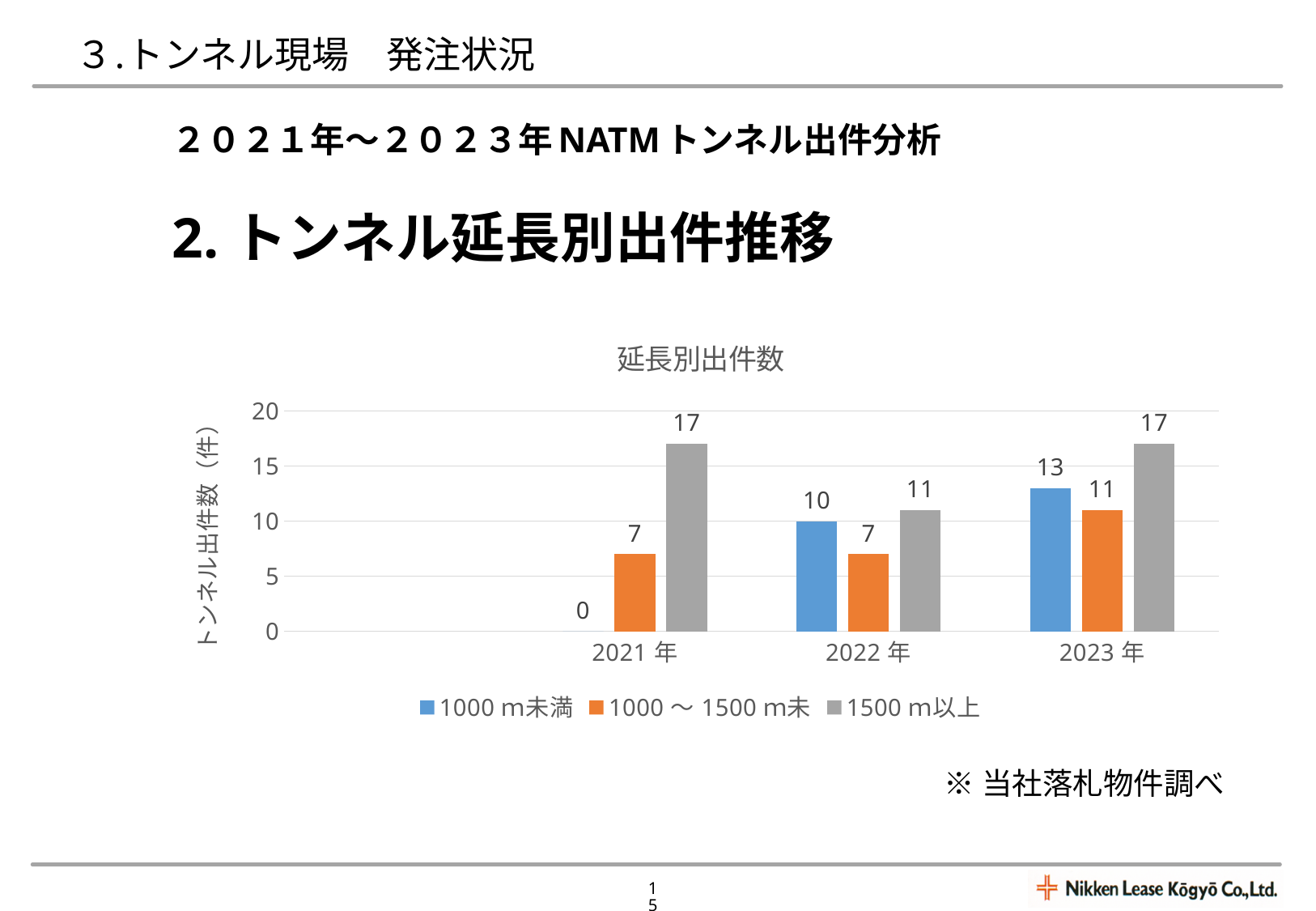
What is the difference between the 1500 m以上 value in 2021 年 and in 2022 年? 6 What is the title of the chart? 延長別出件数 What kind of chart is shown? bar chart How many years are shown on the x axis? 3 What is the value for 1500 m以上 in 2022 年? 11 What is the value for 1000 m未満 in 2021 年? 0 Which is larger in 2022 年: 1000 m未満 or 1000 ～ 1500 m未? 1000 m未満 What is the value for 1000 ～ 1500 m未 in 2023 年? 11 Which year has the lowest value for 1000 ～ 1500 m未? 2021 年 (tied with 2022 年) How many series does the legend list? 3 Which year has the highest value for 1000 m未満? 2023 年 Is the value for 1500 m以上 in 2023 年 greater or less than 15? greater